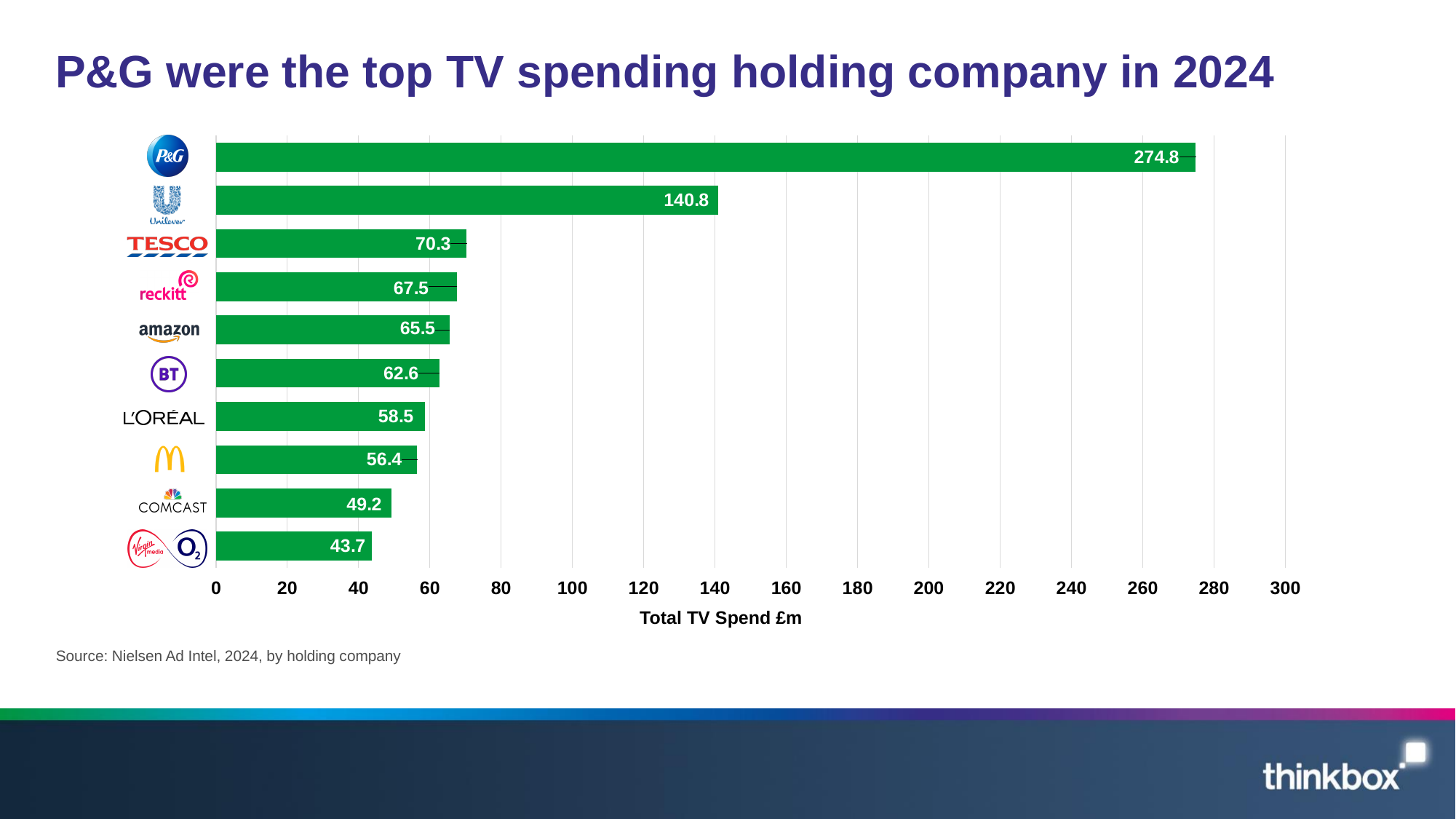
What is the difference in total TV spend between P&G and Unilever? 134 What kind of chart is shown on the slide? bar chart How many holding companies are shown in the chart? 10 What is the label on the x axis of the chart? Total TV Spend £m Is the value for McDonald's greater or less than 60? less What is the total TV spend for Tesco? 70.3 What is the total TV spend for Unilever? 140.8 Which holding company has the lowest total TV spend? Virgin Media O2 Which holding company has the highest total TV spend? P&G What is the total TV spend for Comcast? 49.2 Which has a higher total TV spend, Reckitt or Amazon? Reckitt What is the total TV spend for P&G? 274.8